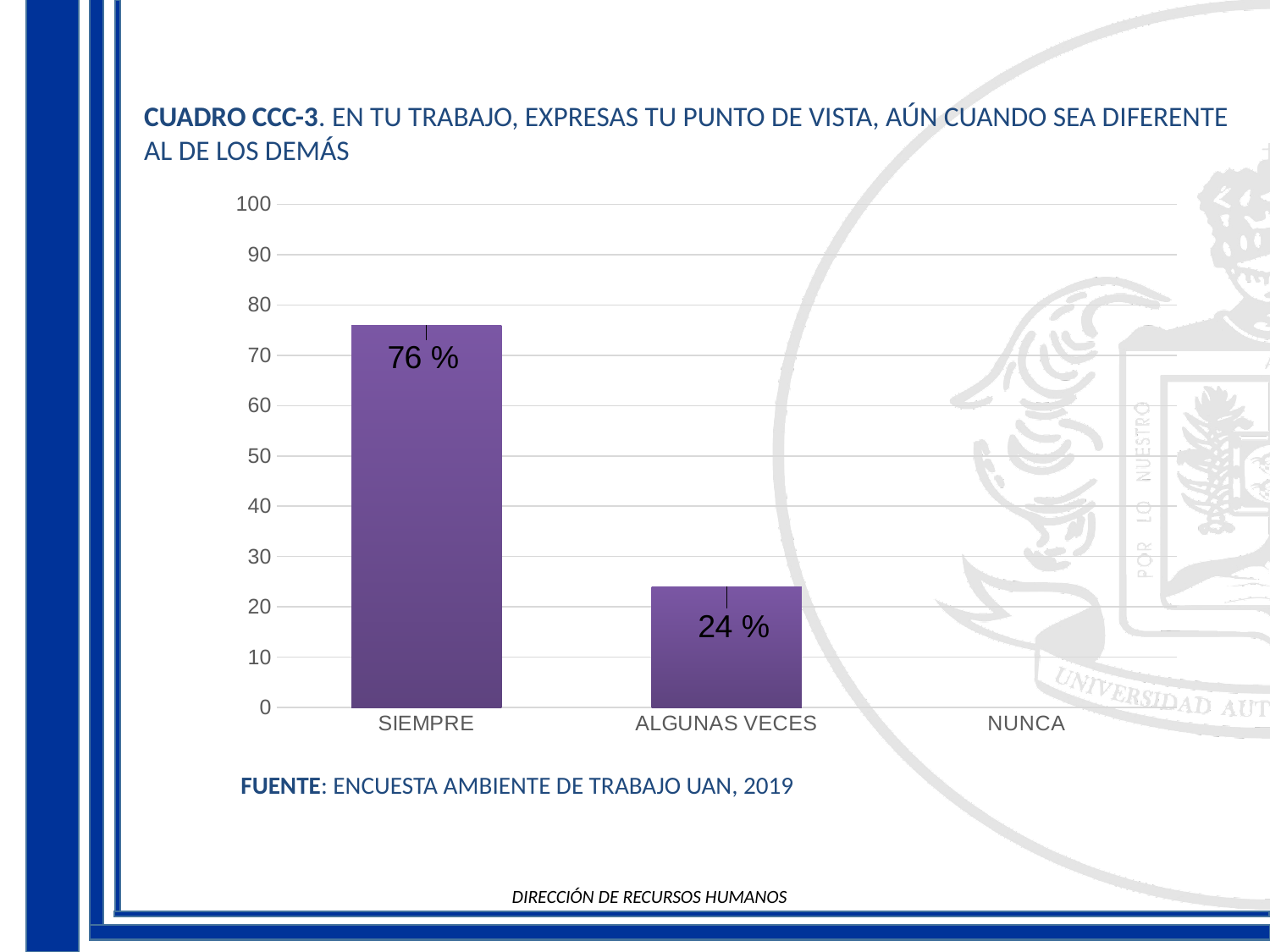
Which category has the highest value? SIEMPRE What is the value for ALGUNAS VECES? 24 % What is the highest value shown on the y axis? 100 What is the value for SIEMPRE? 76 % Which is larger, the value for SIEMPRE or the value for ALGUNAS VECES? SIEMPRE Do the values rise or fall from SIEMPRE to ALGUNAS VECES? fall Is the value for ALGUNAS VECES greater or less than 30? less Is the value for SIEMPRE greater or less than 70? greater What kind of chart is shown on the slide? bar chart What is the difference between the values for SIEMPRE and ALGUNAS VECES? 52 % How many categories are shown on the x axis? 3 What source is cited below the chart? ENCUESTA AMBIENTE DE TRABAJO UAN, 2019